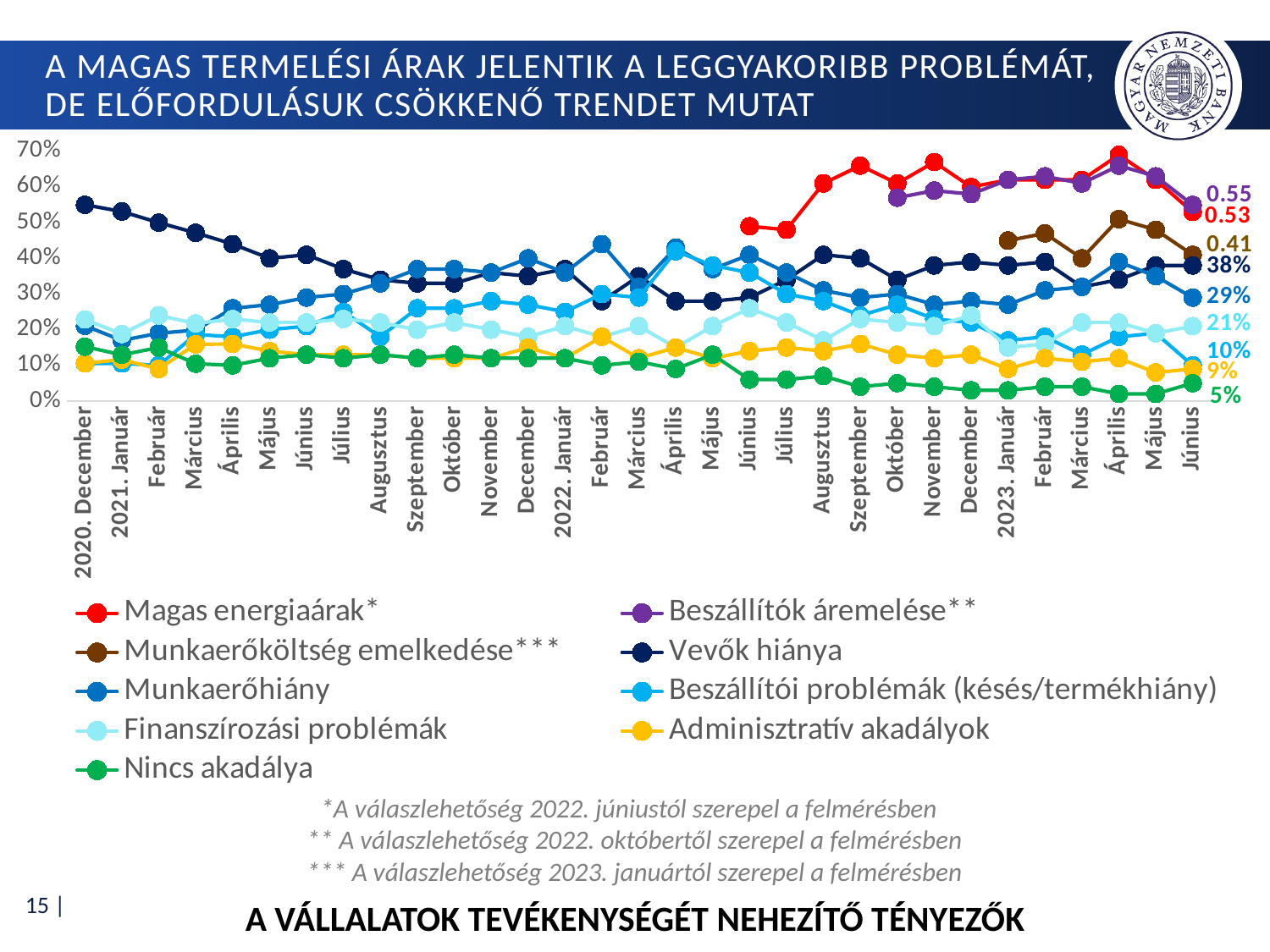
Does the Vevők hiánya series rise or fall overall from 2020. December to 2023 Június? fall Which series has the lowest value at 2023 Június? Nincs akadálya What is the value of the Magas energiaárak series at 2023 Június? 0.53 At 2023 Június, which is larger: Finanszírozási problémák or Beszállítói problémák (késés/termékhiány)? Finanszírozási problémák What is the value of the Beszállítók áremelése series at 2023 Június? 0.55 Is the value of Vevők hiánya at 2020. December greater or less than 50%? greater What is the value of the Vevők hiánya series at 2023 Június? 38% What is the value of the Munkaerőhiány series at 2023 Június? 29% What is the value of the Nincs akadálya series at 2023 Június? 5% How many series does the legend list? 9 At 2023 Június, how much higher is Vevők hiánya than Munkaerőhiány? 9 percentage points Which series has the highest value at 2023 Június? Beszállítók áremelése